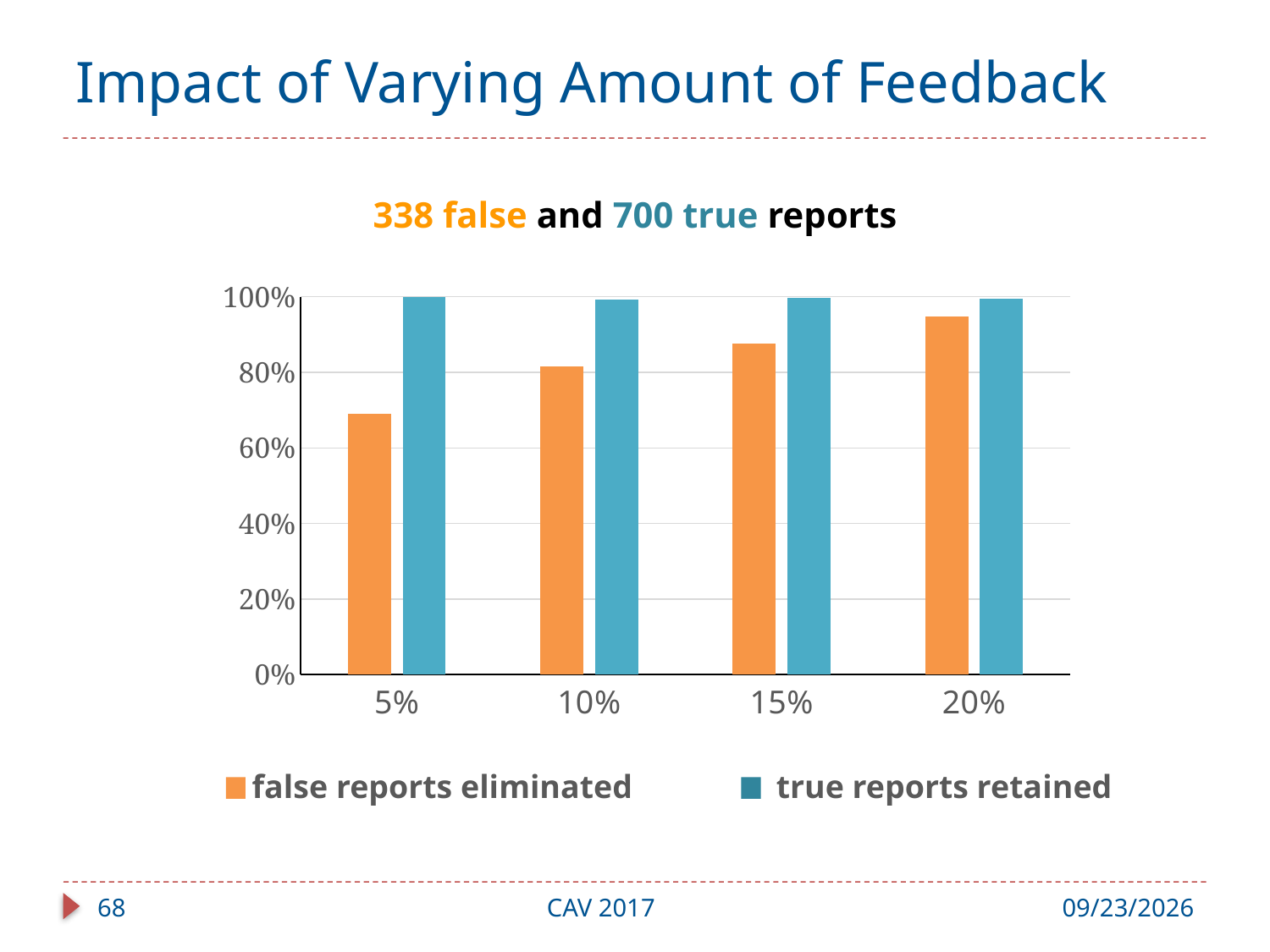
Is the value for true reports retained at 10% greater or less than 80%? greater Do the values for false reports eliminated rise or fall as the feedback amount increases from 5% to 20%? rise For which category is the value for false reports eliminated highest? 20% What is the subtitle above the chart? 338 false and 700 true reports How many series does the legend list? 2 Is the value for false reports eliminated at 5% greater or less than 80%? less What kind of chart is shown on the slide? bar chart Is the value for false reports eliminated at 15% greater or less than 80%? greater How many categories are shown on the x axis? 4 Which series is shown in orange? false reports eliminated For which category is the value for false reports eliminated lowest? 5% At 5%, which is larger: false reports eliminated or true reports retained? true reports retained